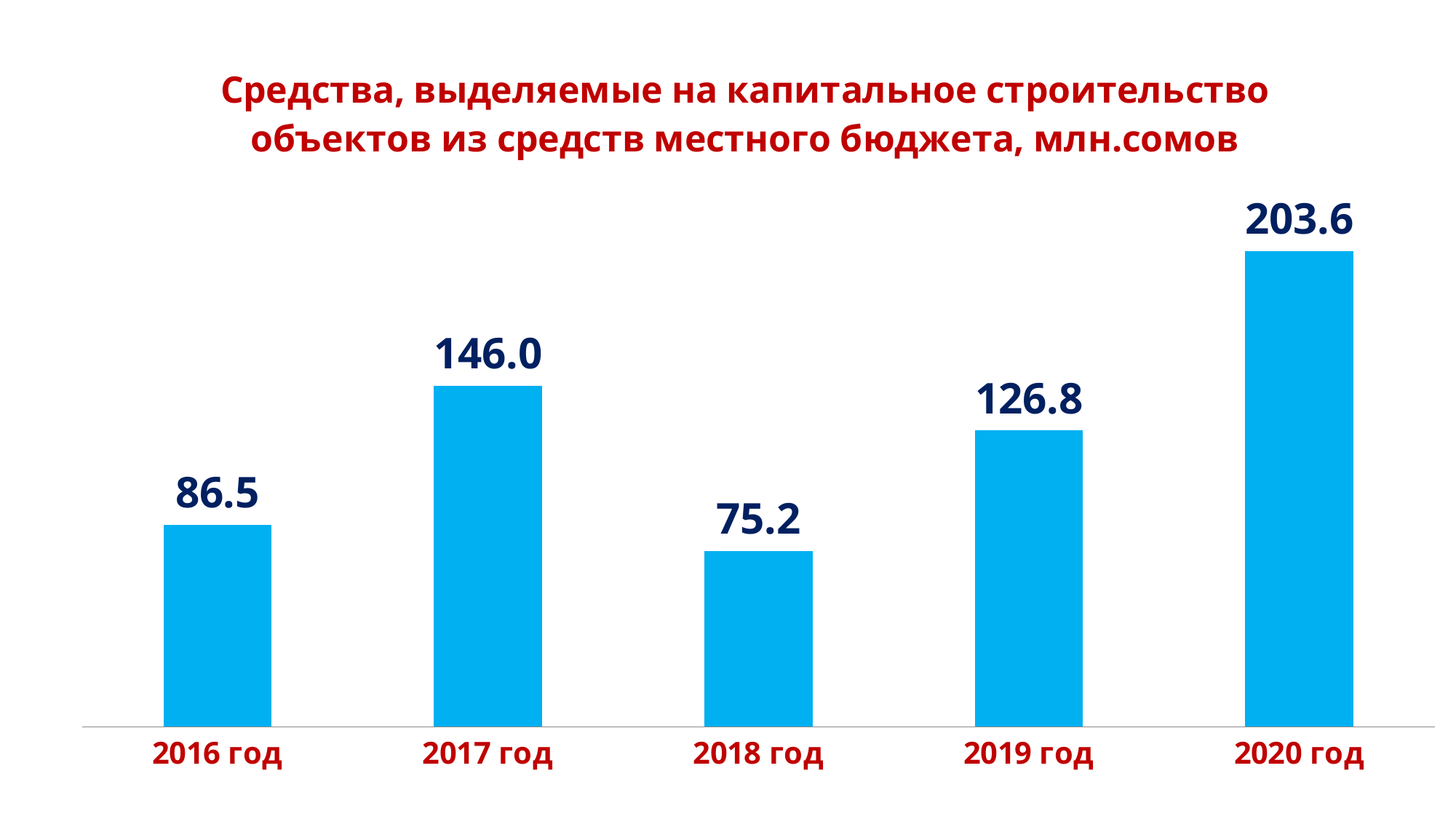
What kind of chart is this? bar chart Which year has the lowest value? 2018 год What is the difference between the values for 2020 год and 2019 год? 76.8 What unit is given in the chart title? млн.сомов What is the value for 2018 год? 75.2 What is the value for 2016 год? 86.5 Which year has the highest value? 2020 год What is the value for 2020 год? 203.6 Does the value rise or fall from 2017 год to 2018 год? fall Which is larger, the value for 2017 год or the value for 2019 год? 2017 год How many years are shown on the chart? 5 What is the difference between the values for 2017 год and 2016 год? 59.5